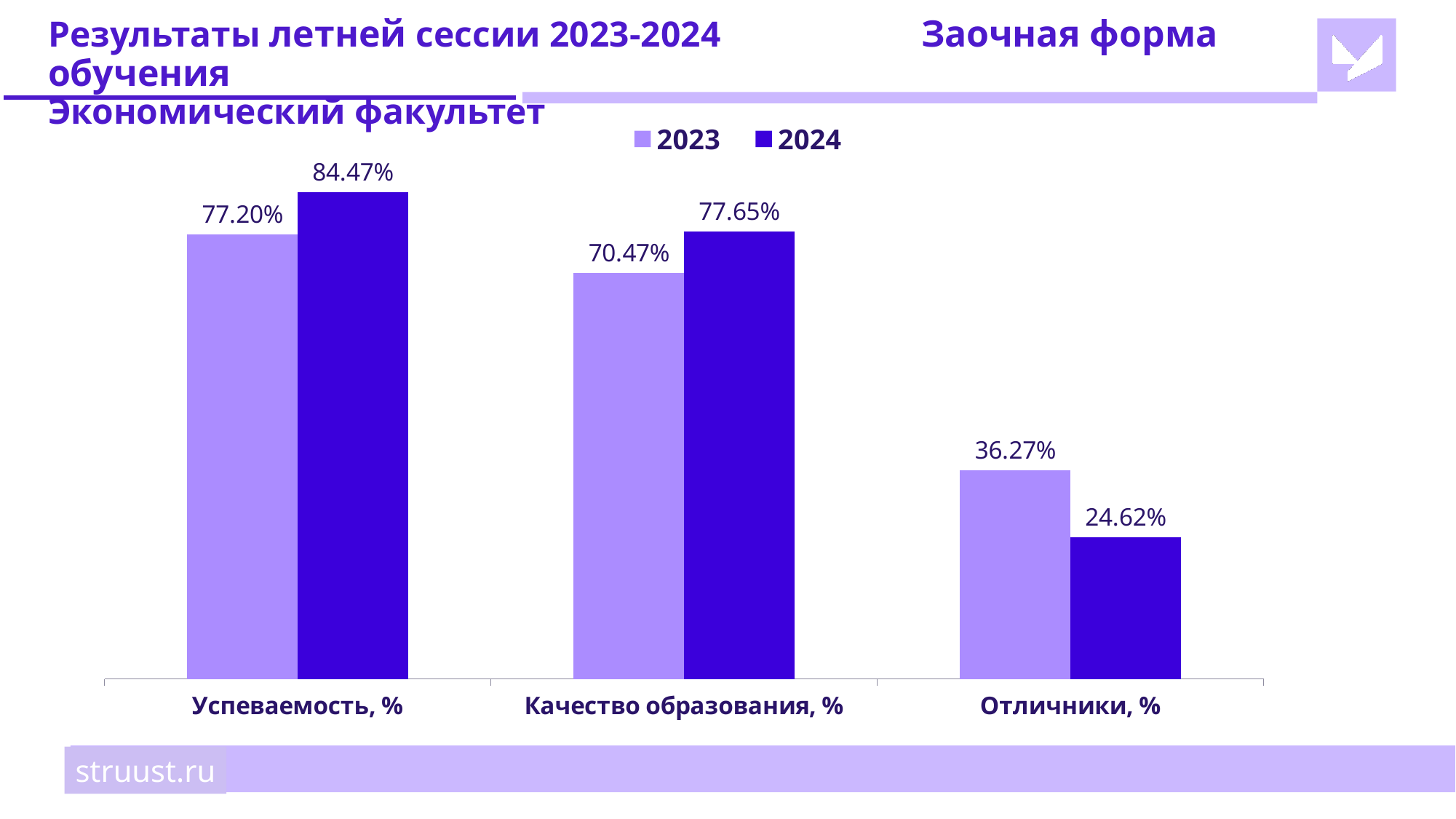
How many categories are shown on the x axis? 3 What is the difference between the 2023 and 2024 values for Отличники, %? 11.65% What is the 2023 value for Качество образования, %? 70.47% How many series does the legend list? 2 Which category has the lowest 2023 value? Отличники, % Which category has the highest 2024 value? Успеваемость, % What is the difference between the 2024 and 2023 values for Успеваемость, %? 7.27% What is the 2024 value for Отличники, %? 24.62% What is the 2023 value for Успеваемость, %? 77.20% What kind of chart is shown on the slide? Bar chart What is the 2024 value for Успеваемость, %? 84.47% Which is larger for Качество образования, %: the 2023 value or the 2024 value? 2024